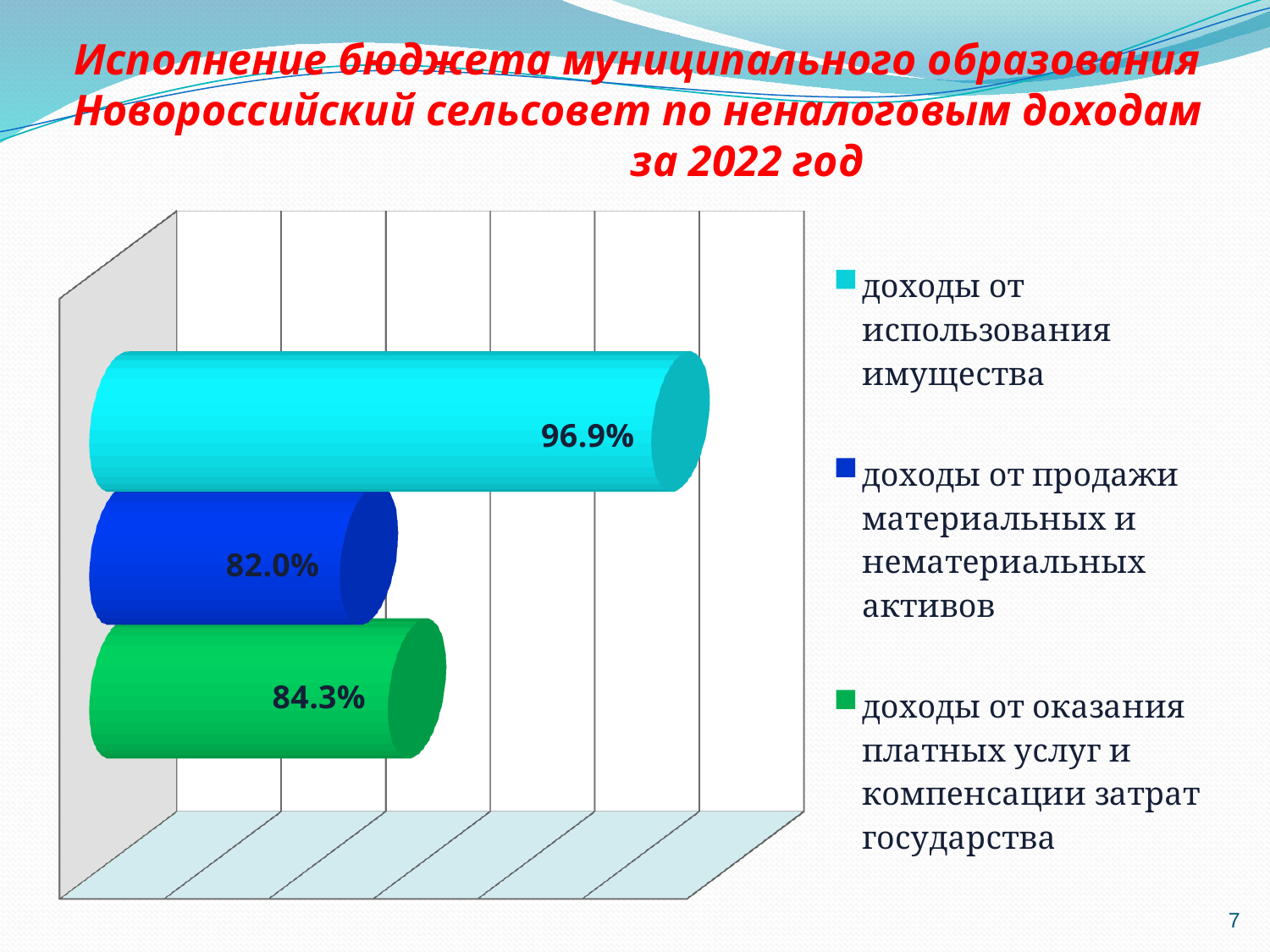
What is the value for доходы от продажи материальных и нематериальных активов? 82.0% What is the value for доходы от использования имущества? 96.9% What colour is the bar for доходы от оказания платных услуг и компенсации затрат государства? green How many entries does the legend list? 3 Which is larger: the value for доходы от оказания платных услуг и компенсации затрат государства or the value for доходы от продажи материальных и нематериальных активов? доходы от оказания платных услуг и компенсации затрат государства What is the difference between the values for доходы от использования имущества and доходы от продажи материальных и нематериальных активов? 14.9% How many categories are shown in the chart? 3 What is the value for доходы от оказания платных услуг и компенсации затрат государства? 84.3% What kind of chart is shown on the slide? bar chart What is the difference between the values for доходы от оказания платных услуг и компенсации затрат государства and доходы от продажи материальных и нематериальных активов? 2.3% Which category has the lowest value? доходы от продажи материальных и нематериальных активов Which category has the highest value? доходы от использования имущества